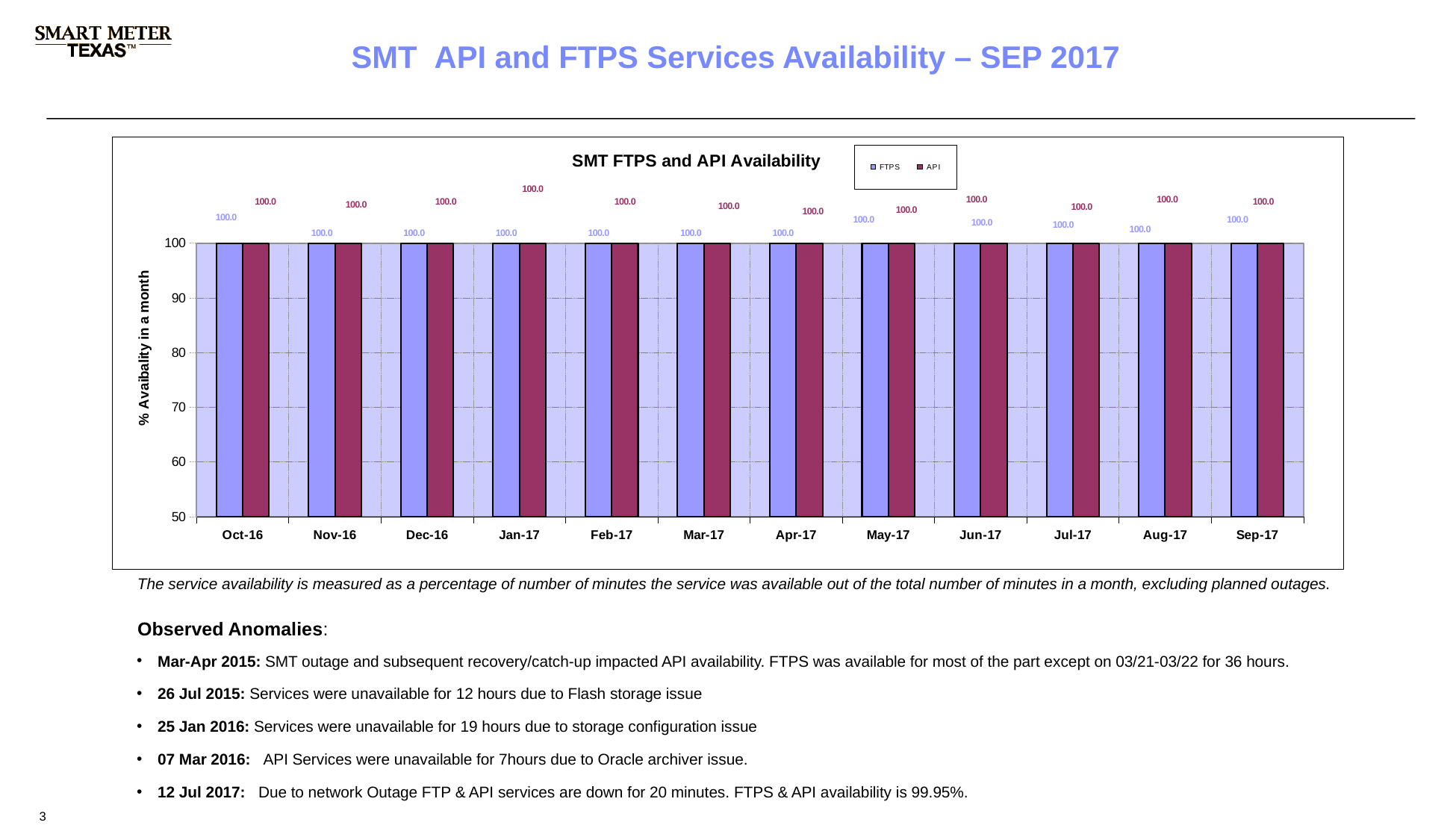
Do the FTPS values rise, fall, or stay flat from Oct-16 to Sep-17? stay flat How many months are shown on the x axis of the chart? 12 How many series does the chart legend list? 2 What is the API availability value for May-17? 100.0 What is the FTPS availability value for Oct-16? 100.0 What is the title of the chart? SMT FTPS and API Availability What is the difference between the FTPS and API values for Jul-17? 0.0 What is the label on the y axis of the chart? % Availabilty in a month What is the FTPS availability value for Jan-17? 100.0 Is the API value for Mar-17 greater or less than 90? greater What kind of chart is shown on the slide? bar chart What is the API availability value for Sep-17? 100.0